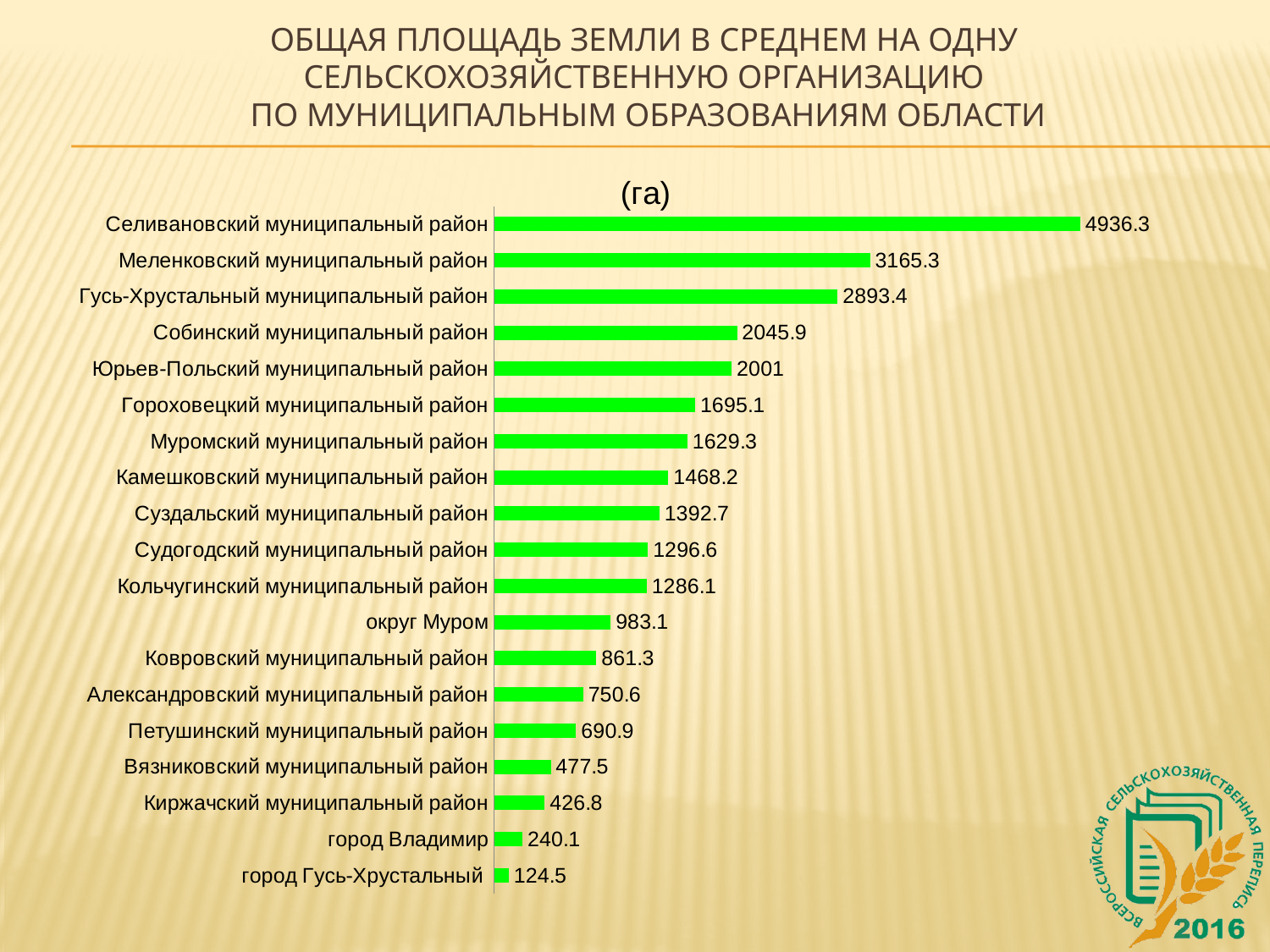
Which category has the lowest value? город Гусь-Хрустальный What is the difference between the values for Меленковский муниципальный район and Гусь-Хрустальный муниципальный район? 271.9 Which is larger, the value for Ковровский муниципальный район or the value for Александровский муниципальный район? Ковровский муниципальный район What is the value for Селивановский муниципальный район? 4936.3 What is the value for округ Муром? 983.1 Which is larger, the value for Вязниковский муниципальный район or the value for Киржачский муниципальный район? Вязниковский муниципальный район What is the value for город Владимир? 240.1 How many categories are shown in the chart? 19 What unit is shown in the chart title above the bars? (га) What kind of chart is shown on the slide? Bar chart Which category has the highest value? Селивановский муниципальный район What is the difference between the values for Собинский муниципальный район and Юрьев-Польский муниципальный район? 44.9